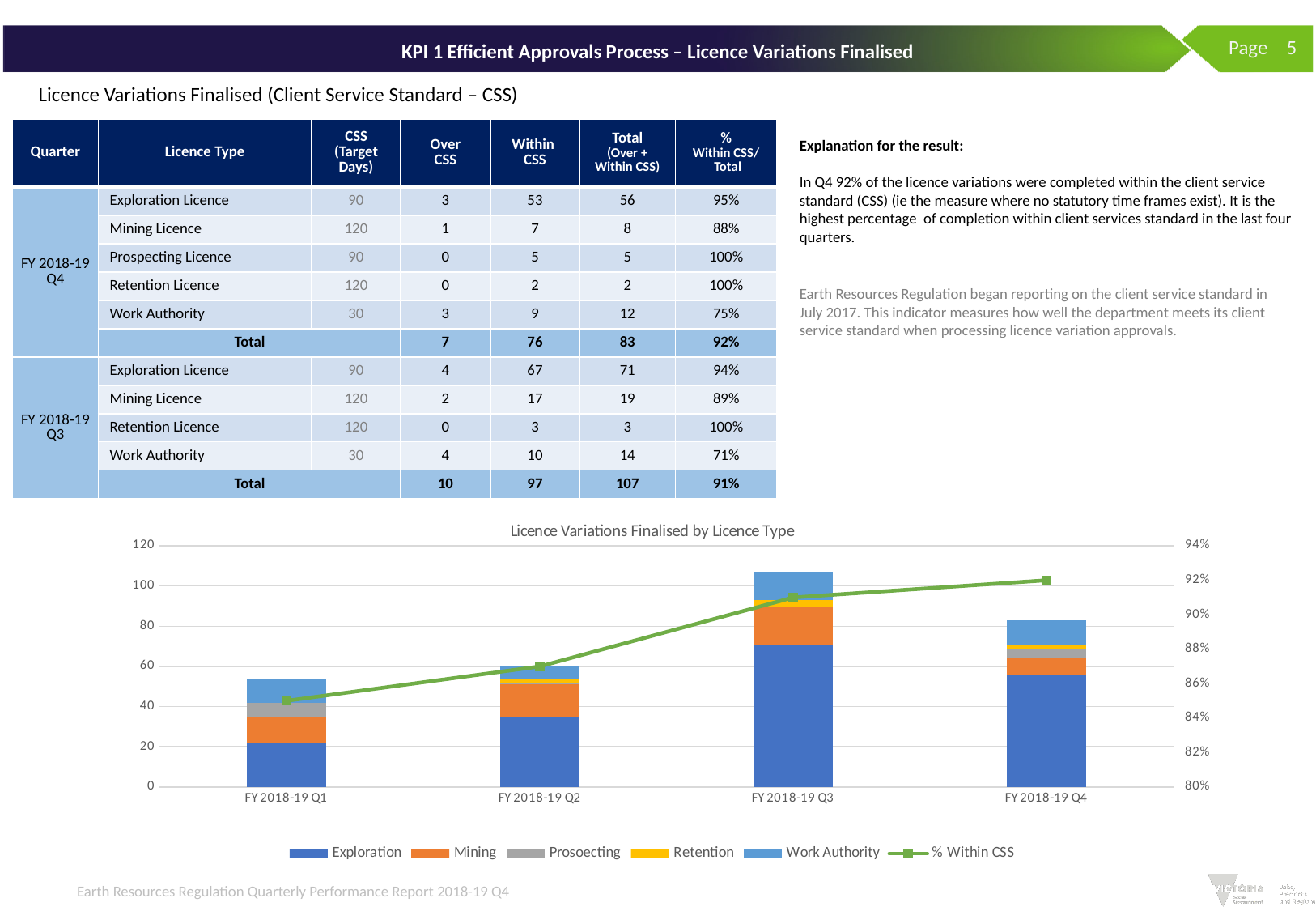
In the 'Licence Variations Finalised by Licence Type' chart, does the % Within CSS line rise or fall from FY 2018-19 Q1 to FY 2018-19 Q4? rise In the 'Licence Variations Finalised by Licence Type' chart, which series is plotted as a line rather than stacked bars? % Within CSS In the 'Licence Variations Finalised by Licence Type' chart, is the total stacked bar for FY 2018-19 Q4 greater or less than 100? less In the 'Licence Variations Finalised by Licence Type' chart, is the % Within CSS value for FY 2018-19 Q1 greater or less than 88%? less In the 'Licence Variations Finalised by Licence Type' chart, which quarter has the shortest stacked bar? FY 2018-19 Q1 How many quarters are shown on the x axis of the 'Licence Variations Finalised by Licence Type' chart? 4 In the 'Licence Variations Finalised by Licence Type' chart, is the total stacked bar for FY 2018-19 Q3 greater or less than 100? greater In the 'Licence Variations Finalised by Licence Type' chart, which quarter has the tallest stacked bar? FY 2018-19 Q3 How many series does the legend of the 'Licence Variations Finalised by Licence Type' chart list? 6 What kind of chart is 'Licence Variations Finalised by Licence Type'? Stacked bar chart with a line